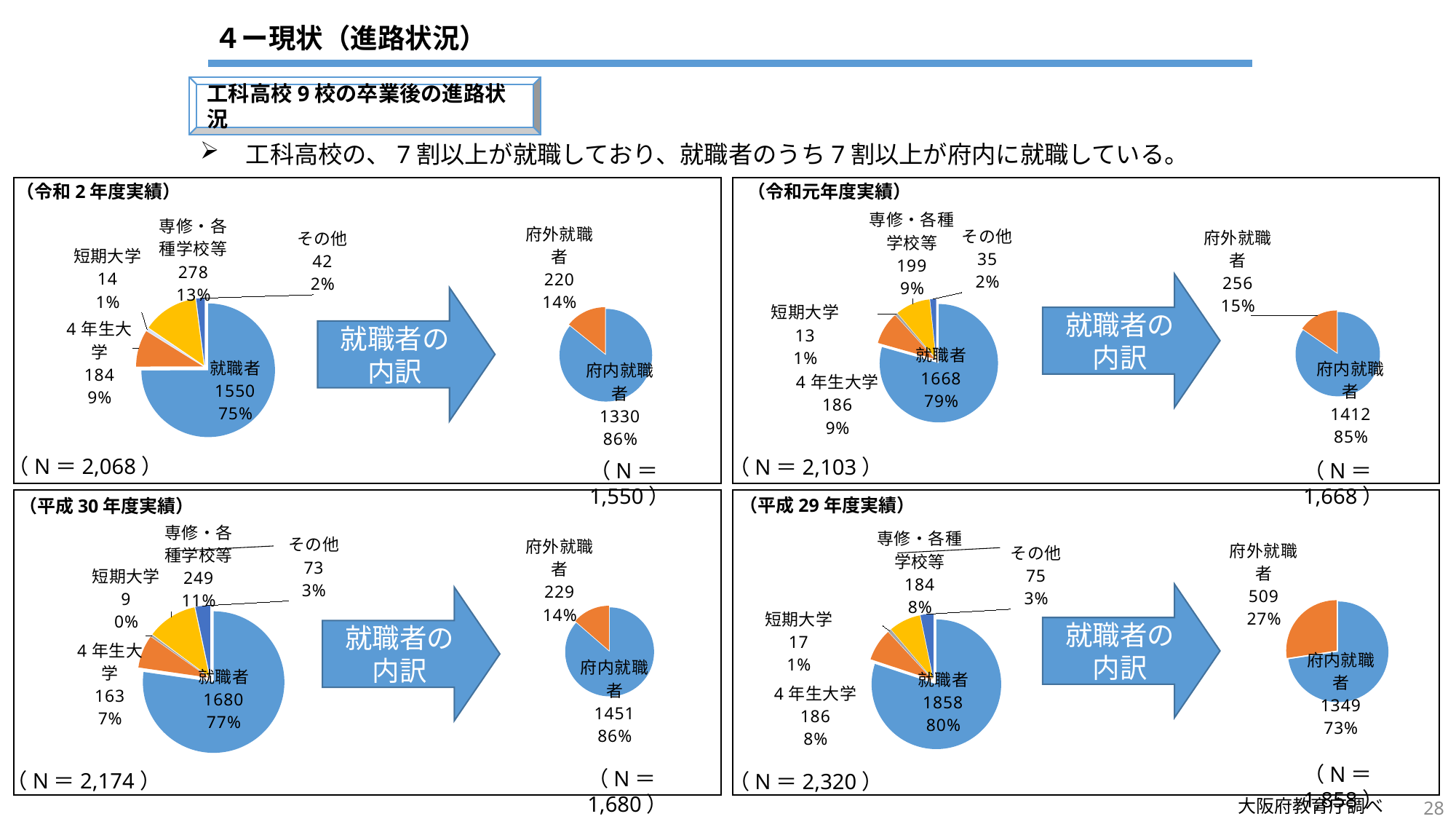
In the 令和2年度実績 panel (top left), what is the difference between the 府内就職者 and 府外就職者 values in the small pie chart? 1110 In the 平成30年度実績 panel (bottom left), which is larger in the large pie chart: 4年生大学 or 専修・各種学校等? 専修・各種学校等 In the 平成29年度実績 panel (bottom right), which category has the largest slice in the large pie chart? 就職者 What is the N value shown for the large pie chart in the 平成29年度実績 panel (bottom right)? 2,320 In the 平成30年度実績 panel (bottom left), which category has the smallest slice in the large pie chart? 短期大学 How many categories does the large pie chart in the 令和元年度実績 panel (top right) have? 5 In the 平成29年度実績 panel (bottom right), what percentage does the 府外就職者 slice show in the small pie chart? 27% In the 平成30年度実績 panel (bottom left), what is the value shown for その他 in the large pie chart? 73 In the 令和2年度実績 panel (top left), what is the value shown for 就職者 in the large pie chart? 1550 In the 令和2年度実績 panel (top left), what percentage does the 専修・各種学校等 slice show in the large pie chart? 13% In the 令和元年度実績 panel (top right), what is the value shown for 府内就職者 in the small pie chart? 1412 What type of chart is used in the 平成29年度実績 panel (bottom right)? Pie chart